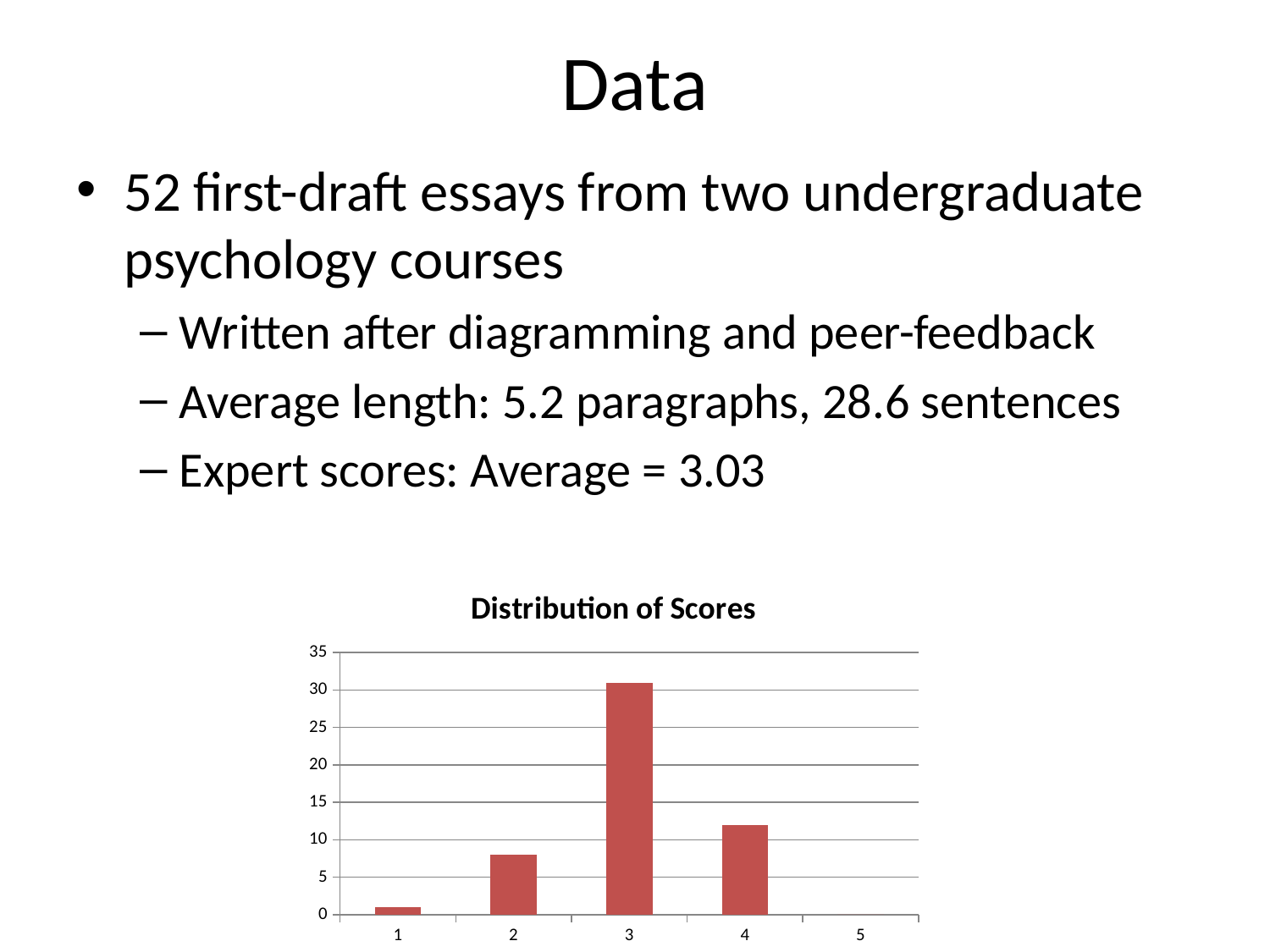
Which has a larger value in the chart, score 2 or score 4? 4 Is the value for score 1 greater or less than 5? less Which has a larger value in the chart, score 3 or score 4? 3 Which score category has the tallest bar in the chart? 3 Is the value for score 4 greater or less than 10? greater What is the title of the chart on the slide? Distribution of Scores What kind of chart is shown under the title "Distribution of Scores"? bar chart What colour are the bars in the chart? red Which score category has the lowest value in the chart? 5 How many score categories are shown on the x axis of the chart? 5 Is the value for score 2 greater or less than 10? less